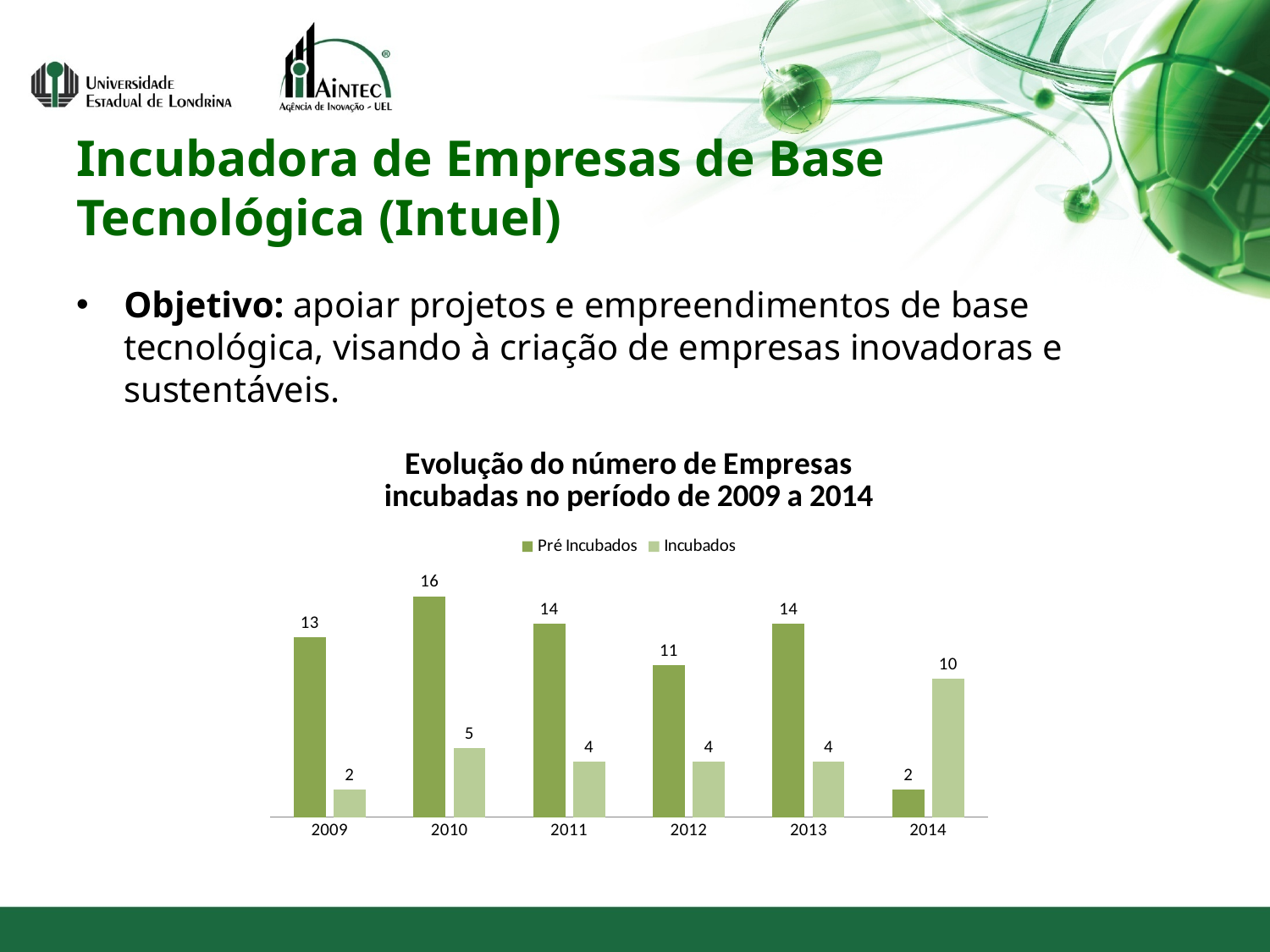
What is the difference between Pré Incubados and Incubados in 2013? 10 What is the value for Incubados in 2009? 2 How many series does the legend list? 2 What is the value for Incubados in 2014? 10 What is the title of the chart? Evolução do número de Empresas incubadas no período de 2009 a 2014 Which is larger in 2014, Pré Incubados or Incubados? Incubados What is the value for Pré Incubados in 2010? 16 Which year has the highest value for Pré Incubados? 2010 Which year has the lowest value for Pré Incubados? 2014 What kind of chart is shown on the slide? Bar chart How many years are shown on the x axis? 6 Which year has the highest value for Incubados? 2014